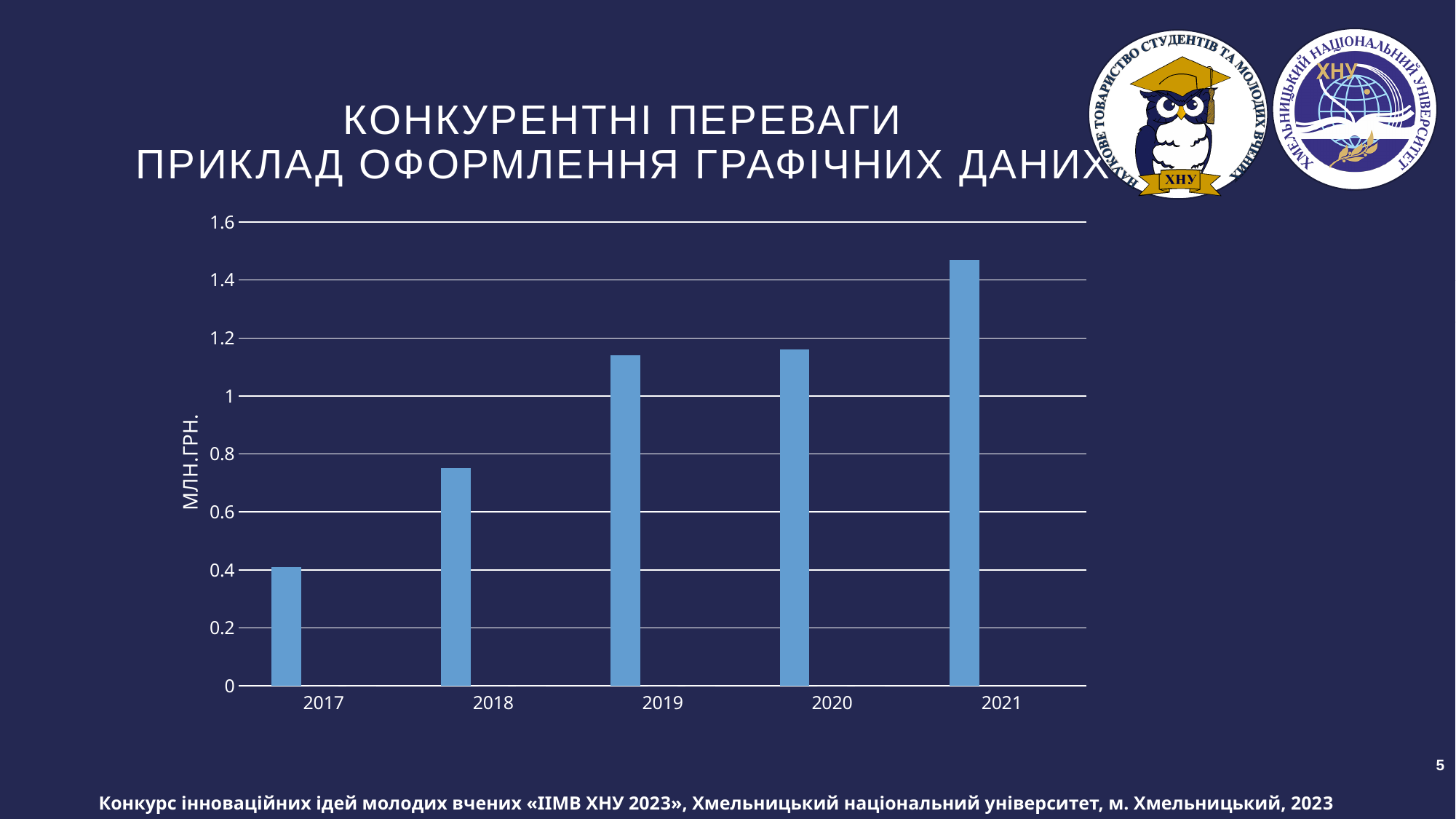
Is the value for 2021 greater or less than 1.4? greater Do the values generally rise or fall from 2017 to 2021? rise Which year has the highest bar in the chart? 2021 How many years are shown on the x axis of the chart? 5 Is the value for 2017 greater or less than 0.6? less What kind of chart is shown on the slide? bar chart Is the value for 2019 greater or less than 1? greater What is the label on the vertical axis of the chart? МЛН.ГРН. Which is larger, the value for 2020 or the value for 2021? 2021 Which is larger, the value for 2018 or the value for 2019? 2019 Which year has the lowest bar in the chart? 2017